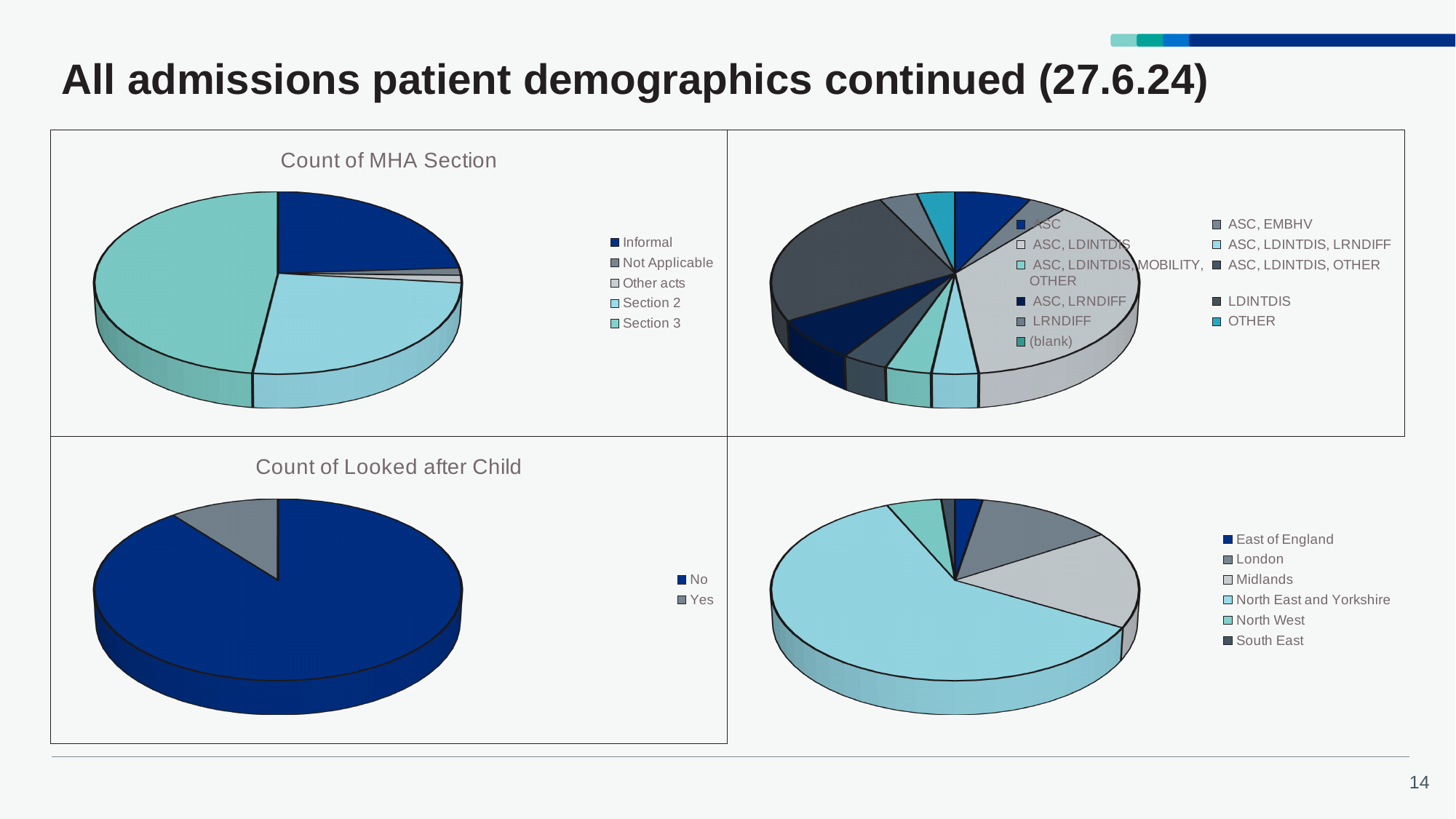
In the "Count of MHA Section" chart, which category has the largest slice? Section 3 In the "Count of Looked after Child" chart, which category has the smallest slice? Yes In the bottom-right pie chart (regions), which slice is larger, North East and Yorkshire or London? North East and Yorkshire In the "Count of Looked after Child" chart, which category has the largest slice? No How many categories does the legend of the top-right pie chart (ASC categories) list? 11 How many categories does the legend of the bottom-right pie chart (regions) list? 6 How many categories are shown in the "Count of Looked after Child" chart? 2 In the bottom-right pie chart (regions), which category has the largest slice? North East and Yorkshire What kind of chart is the "Count of MHA Section" chart? pie chart